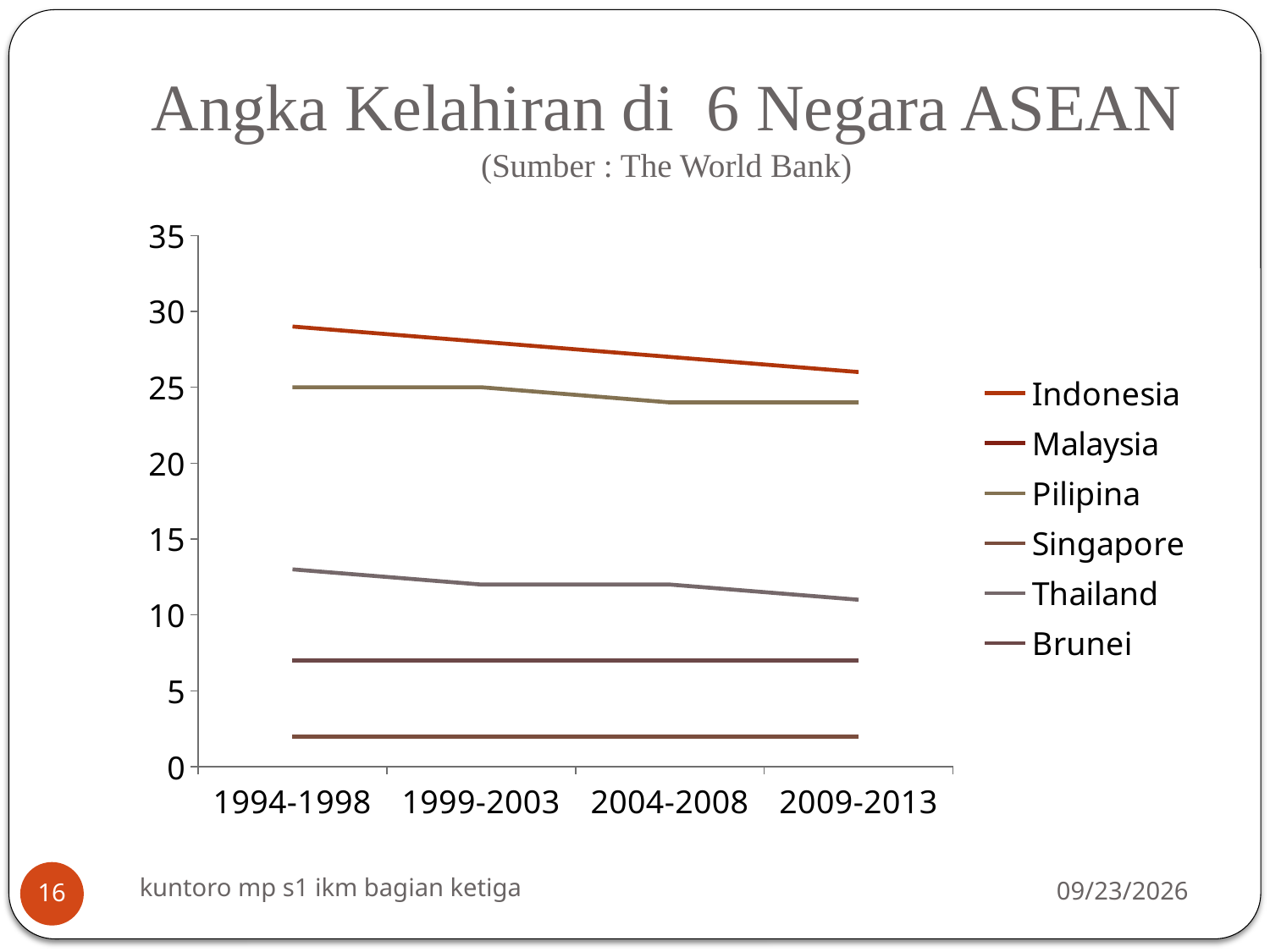
Is the value for Thailand in 1994-1998 greater or less than 10? greater How many series does the legend list? 6 Is the value for Indonesia in 2009-2013 greater or less than 30? less Does the Indonesia line rise or fall from 1994-1998 to 2009-2013? fall Which country has the highest value in 1994-1998? Indonesia Is the value for Indonesia in 1994-1998 greater or less than 25? greater How many time periods are shown on the x axis? 4 Does the Thailand line rise or fall from 1994-1998 to 2009-2013? fall What kind of chart is shown on the slide? line chart In 2009-2013, which is larger: the value for Indonesia or the value for Pilipina? Indonesia What source is cited under the chart title? The World Bank